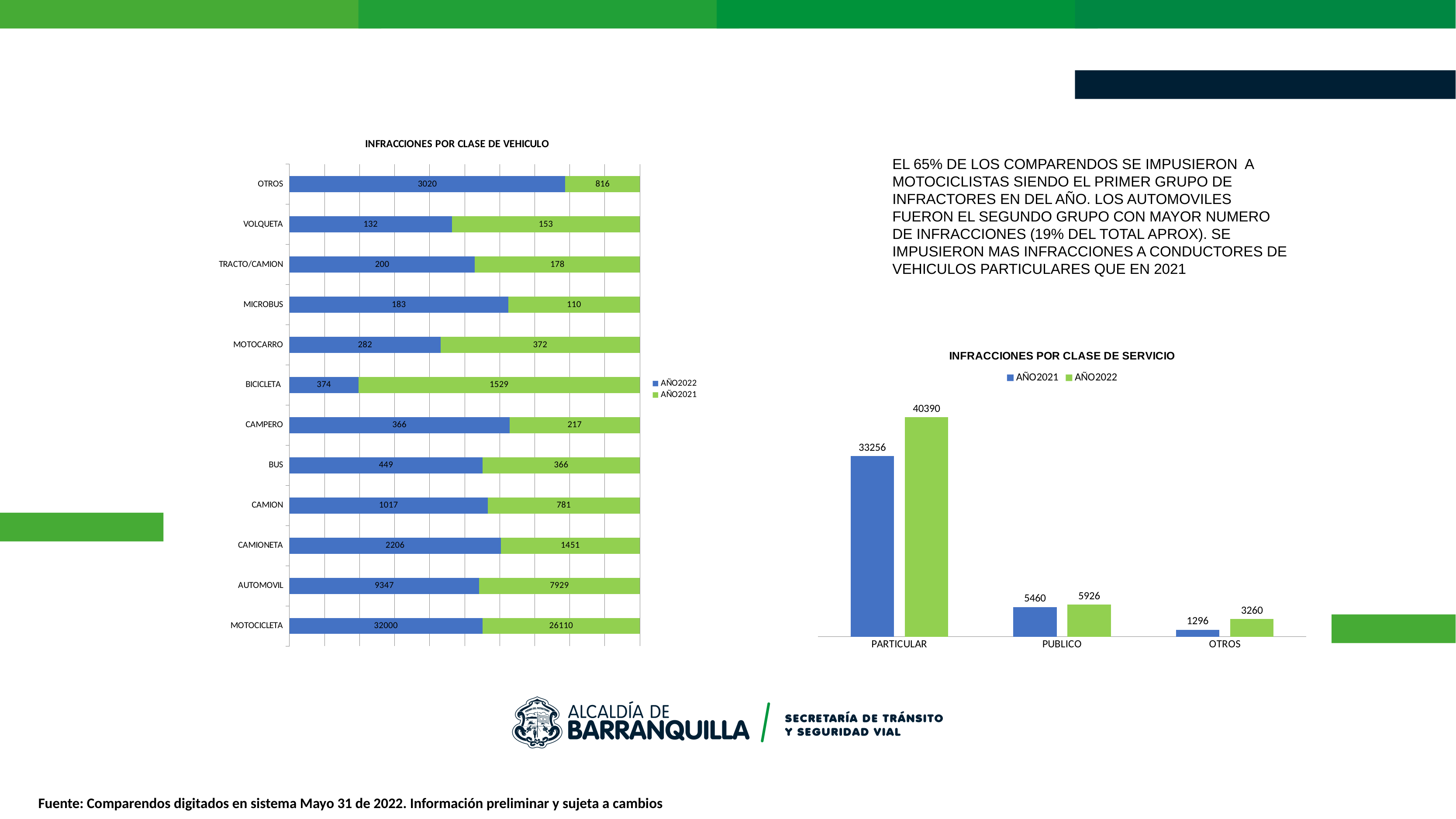
How many series does the legend of the chart 'INFRACCIONES POR CLASE DE SERVICIO' list? 2 In the chart 'INFRACCIONES POR CLASE DE VEHICULO', which vehicle class has the highest AÑO2022 value? MOTOCICLETA In the chart 'INFRACCIONES POR CLASE DE VEHICULO', what is the AÑO2021 value for BICICLETA? 1529 How many vehicle classes are shown in the chart 'INFRACCIONES POR CLASE DE VEHICULO'? 12 In the chart 'INFRACCIONES POR CLASE DE VEHICULO', which vehicle class has the lowest AÑO2022 value? VOLQUETA In the chart 'INFRACCIONES POR CLASE DE SERVICIO', what is the difference between the AÑO2022 and AÑO2021 values for PUBLICO? 466 In the chart 'INFRACCIONES POR CLASE DE SERVICIO', what is the AÑO2022 value for PARTICULAR? 40390 In the chart 'INFRACCIONES POR CLASE DE VEHICULO', which is larger for MOTOCARRO: the AÑO2022 value or the AÑO2021 value? AÑO2021 In the chart 'INFRACCIONES POR CLASE DE VEHICULO', what is the AÑO2022 value for MOTOCICLETA? 32000 What type of chart is 'INFRACCIONES POR CLASE DE SERVICIO'? Bar chart In the chart 'INFRACCIONES POR CLASE DE SERVICIO', what is the AÑO2021 value for OTROS? 1296 In the chart 'INFRACCIONES POR CLASE DE VEHICULO', what is the difference between the AÑO2022 and AÑO2021 values for AUTOMOVIL? 1418